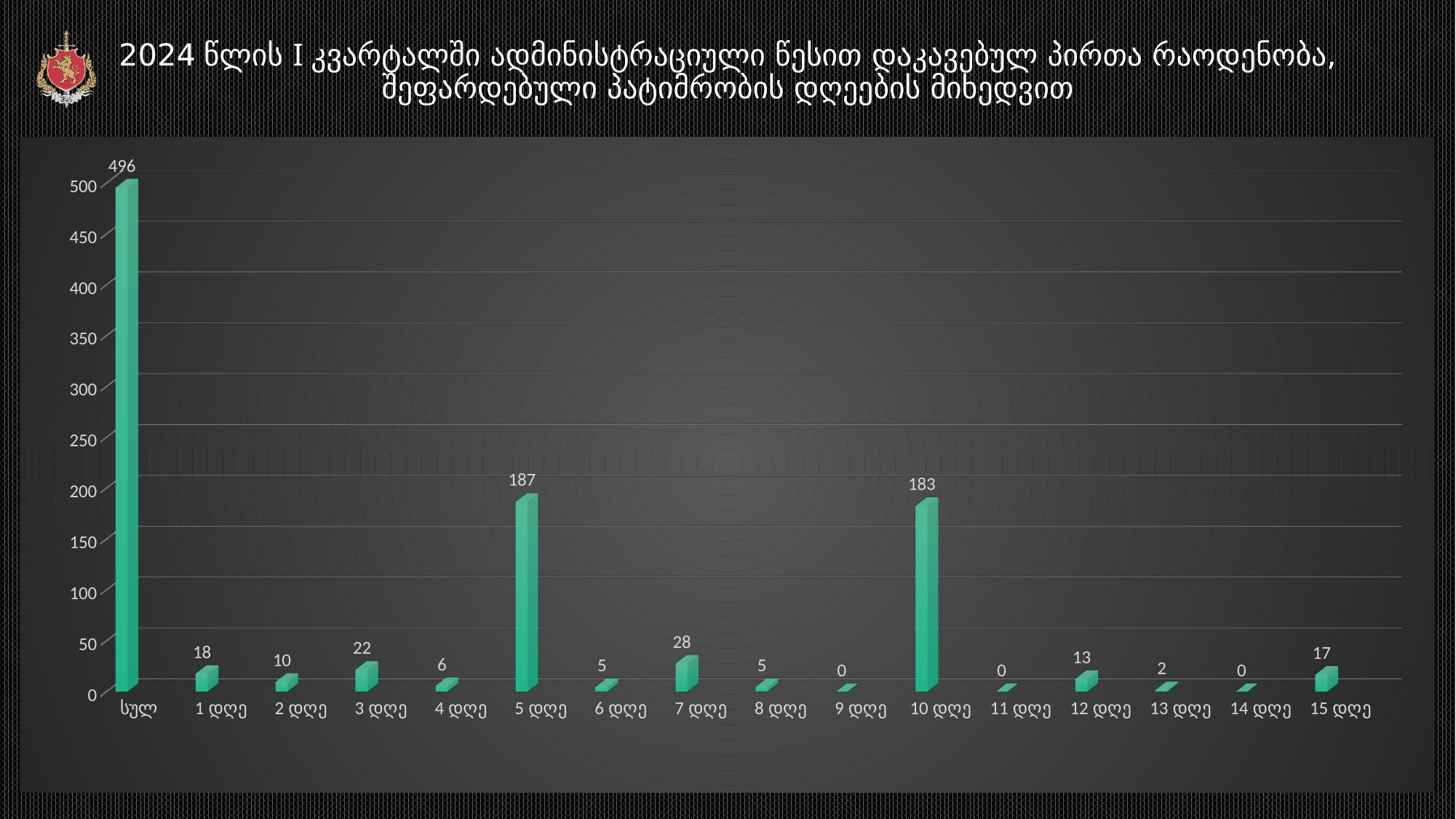
What is the value for "5 დღე"? 187 Which is larger, the value for "3 დღე" or the value for "1 დღე"? 3 დღე Excluding the "სულ" total bar, which day category has the highest value? 5 დღე What is the value for the "სულ" bar? 496 What kind of chart is shown on the slide? bar chart What is the difference between the values for "5 დღე" and "10 დღე"? 4 What is the difference between the values for "12 დღე" and "13 დღე"? 11 What is the value for "10 დღე"? 183 How many categories are shown on the x axis? 16 How many categories have a value of 0? 3 What is the value for "7 დღე"? 28 Is the value for "სულ" greater or less than 450? greater